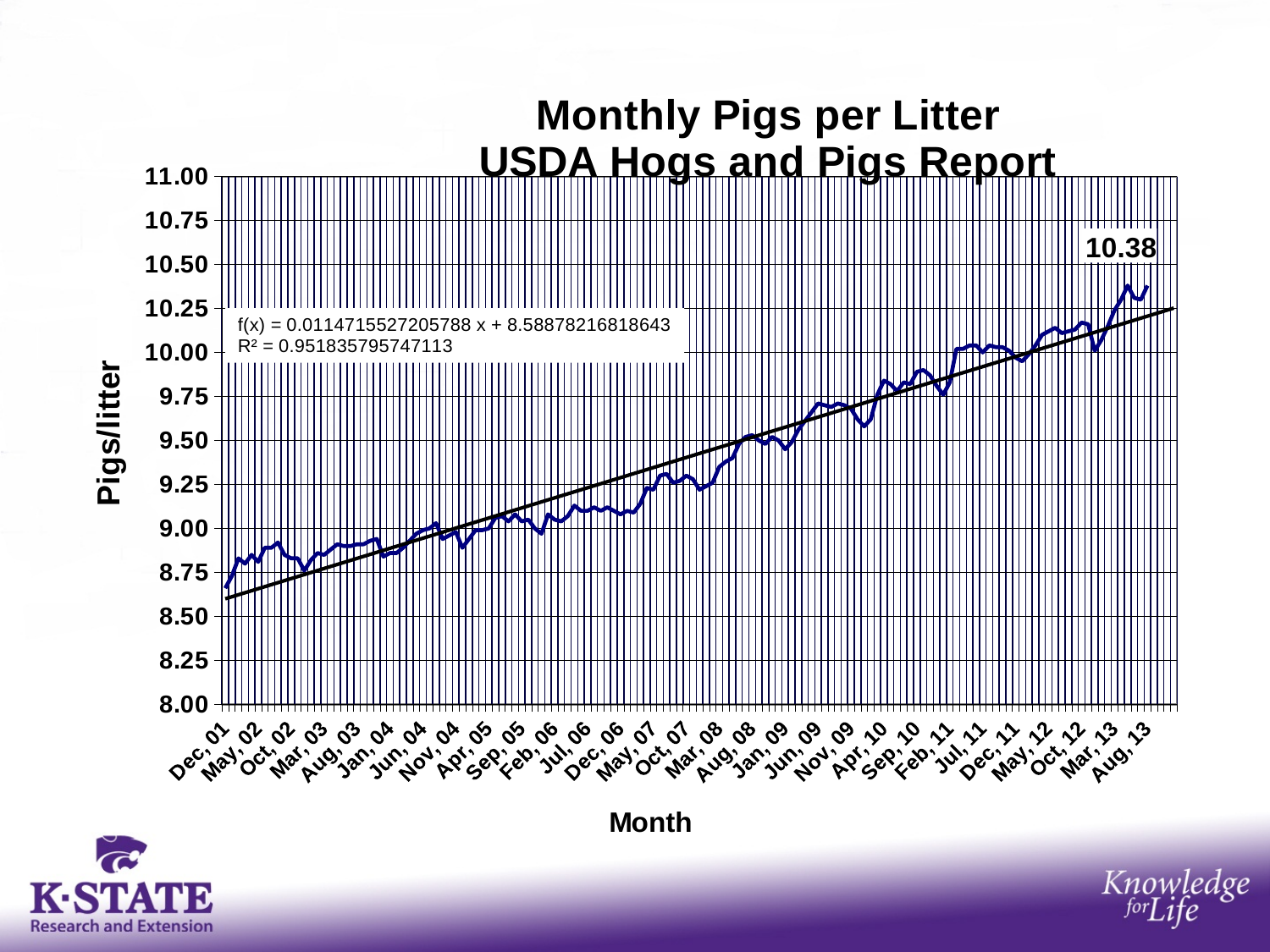
What is the title of the chart? Monthly Pigs per Litter USDA Hogs and Pigs Report What is the highest value printed as a data label on the chart? 10.38 Which month has the lowest pigs per litter value on the chart? Dec, 01 Is the value for Jun, 09 greater or less than 9.50? greater Do the pigs per litter values generally rise or fall from Dec, 01 to Aug, 13? rise What is the label of the vertical axis? Pigs/litter Is the value for Dec, 01 greater or less than 9.00? less What is the data label shown at the end of the line, for Aug, 13? 10.38 What is the R² value shown for the trendline? 0.951835795747113 Is the value for Aug, 13 greater or less than 10.50? less What kind of chart is shown on the slide? line chart